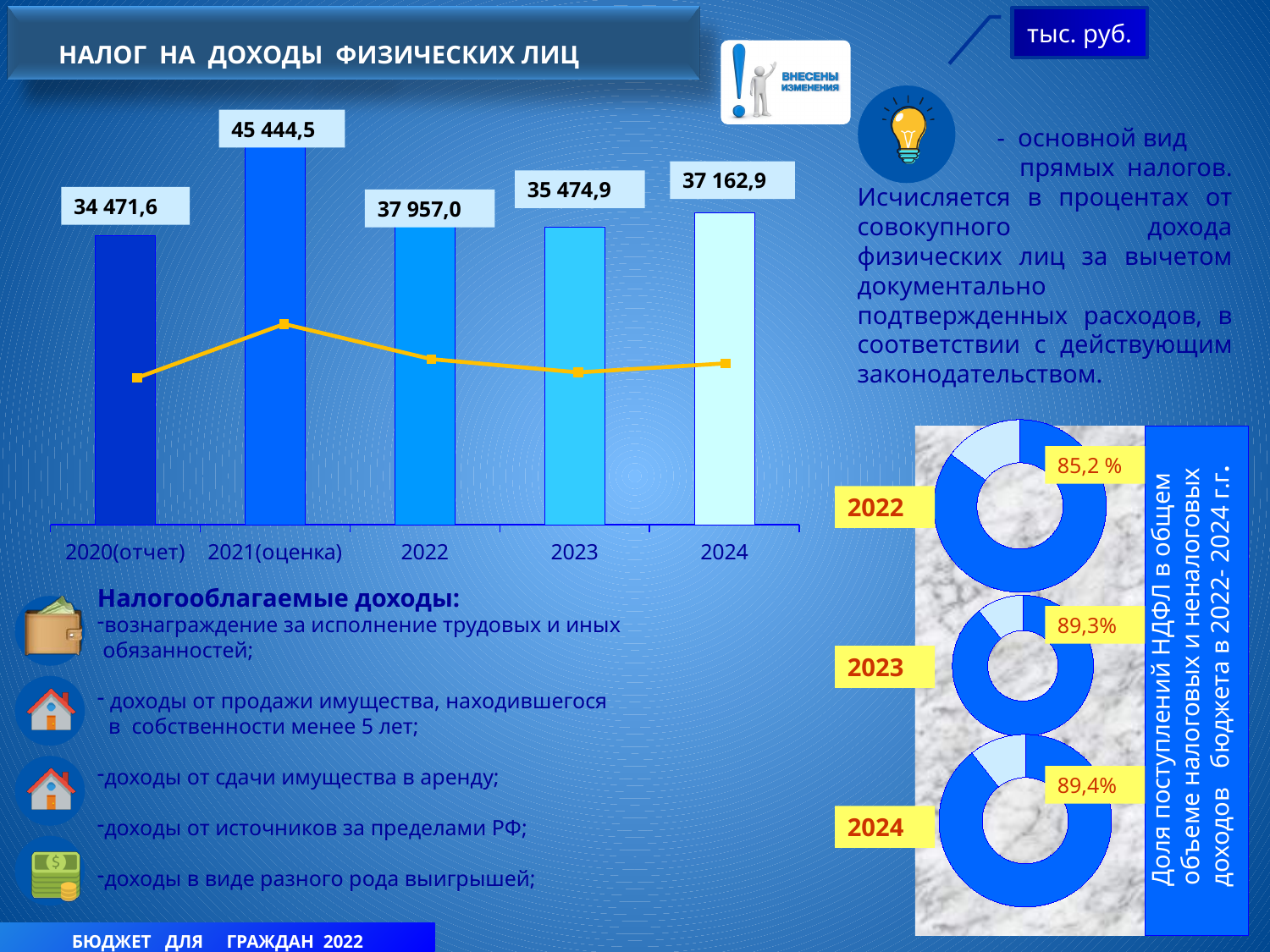
What kind of chart is the large chart on the left of the slide? Bar chart with a line overlay In the bar chart, do the values rise or fall from 2021(оценка) to 2023? Fall In the bar chart, what is the value for 2021(оценка)? 45 444,5 In the bar chart, which is larger: the value for 2022 or the value for 2024? 2022 In the bar chart, what is the value for 2020(отчет)? 34 471,6 In the donut charts on the right, what share is shown for 2022? 85,2 % In the bar chart, which year has the highest value? 2021(оценка) In the bar chart, what is the difference between the values for 2022 and 2023? 2 482,1 In the bar chart, what is the value for 2023? 35 474,9 How many years are shown on the x axis of the bar chart? 5 In the bar chart, which year has the lowest value? 2020(отчет) In the bar chart, what is the difference between the values for 2021(оценка) and 2020(отчет)? 10 972,9